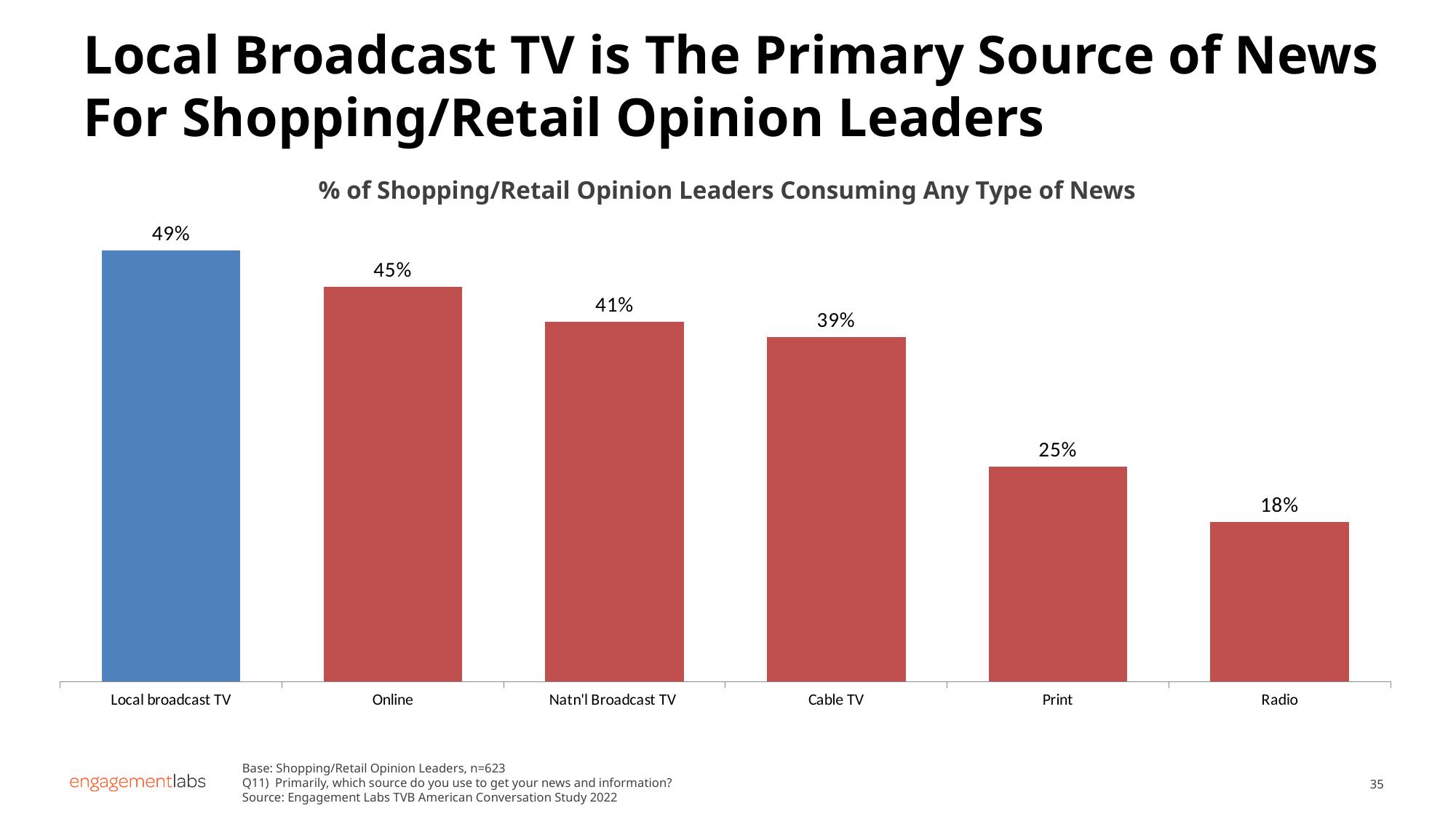
What is the value shown for Radio? 18% Which bar is coloured blue rather than red? Local broadcast TV Which news source has the highest percentage? Local broadcast TV What is the difference between the values for Local broadcast TV and Online? 4% Which news source has the lowest percentage? Radio What percentage of Shopping/Retail Opinion Leaders use Local broadcast TV as their news source? 49% What is the value shown for Cable TV? 39% Which is larger, the value for Natn'l Broadcast TV or the value for Cable TV? Natn'l Broadcast TV How many news sources are shown in the chart? 6 What is the value shown for Online? 45% What kind of chart is shown on the slide? Bar chart What is the difference between the values for Print and Radio? 7%